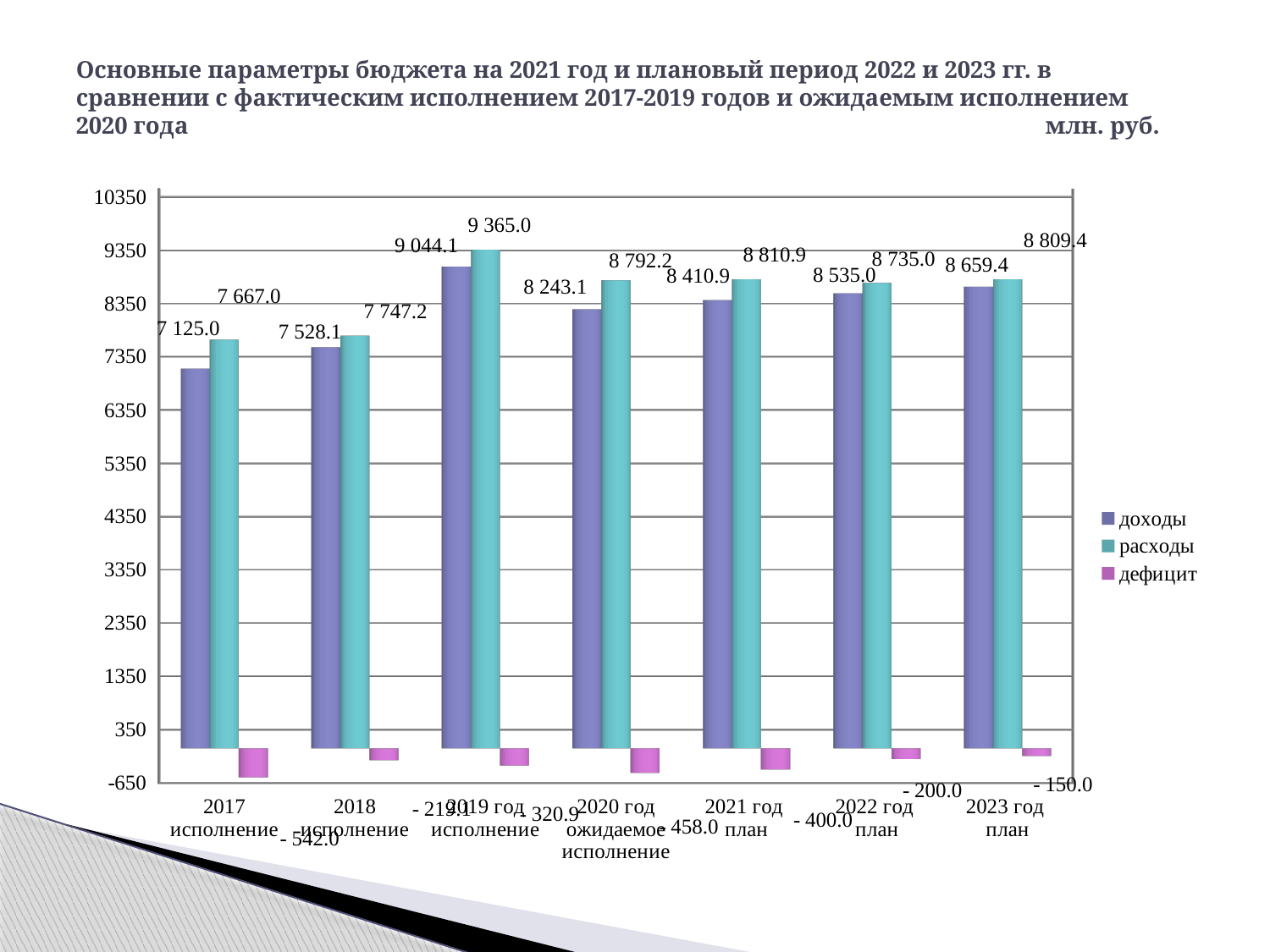
Which category has the highest value of расходы? 2019 год исполнение Which is larger: доходы for 2022 год план or доходы for 2020 год ожидаемое исполнение? 2022 год план What is the value of расходы for 2019 год исполнение? 9 365.0 What is the value of дефицит for 2023 год план? - 150.0 How many series does the legend list? 3 How many categories are shown on the x axis? 7 Which category has the lowest value of доходы? 2017 исполнение What is the value of доходы for 2017 исполнение? 7 125.0 What kind of chart is shown on the slide? bar chart Is the value of расходы for 2018 исполнение greater or less than 8350? less What is the difference between расходы and доходы for 2021 год план? 400.0 Do the values of доходы rise or fall from 2020 год ожидаемое исполнение to 2023 год план? rise